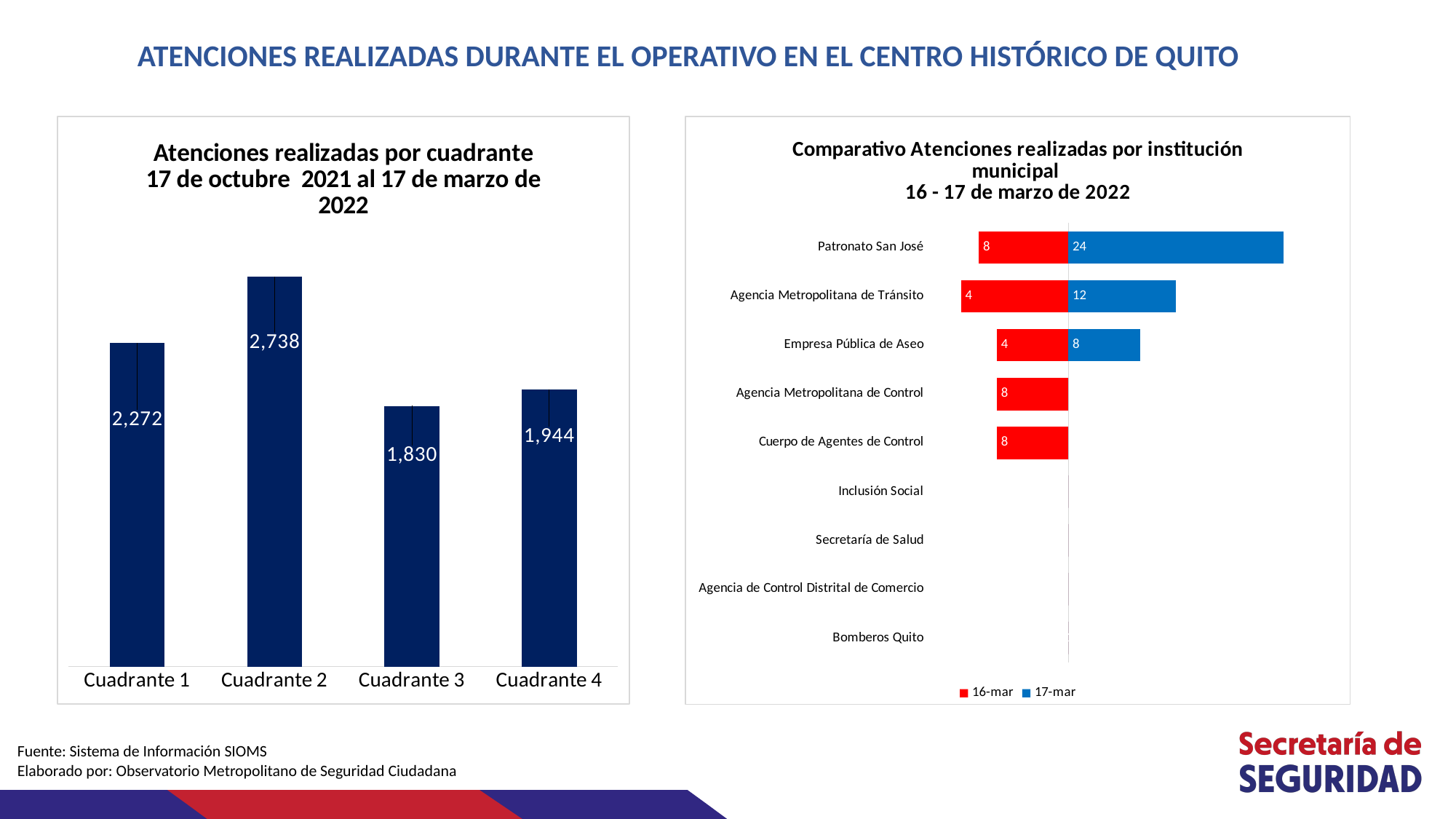
In the 'Comparativo Atenciones realizadas por institución municipal' chart, how many series does the legend list? 2 In the 'Comparativo Atenciones realizadas por institución municipal' chart, what is the 16-mar value for Agencia Metropolitana de Tránsito? 4 In the 'Comparativo Atenciones realizadas por institución municipal' chart, what is the 17-mar value for Patronato San José? 24 What kind of chart is the 'Atenciones realizadas por cuadrante' chart? Bar chart In the 'Comparativo Atenciones realizadas por institución municipal' chart, what is the difference between the 17-mar and 16-mar values for Empresa Pública de Aseo? 4 In the 'Atenciones realizadas por cuadrante' chart, how many cuadrantes are shown? 4 In the 'Atenciones realizadas por cuadrante' chart, what is the difference between Cuadrante 1 and Cuadrante 4? 328 In the 'Atenciones realizadas por cuadrante' chart, which cuadrante has the lowest value? Cuadrante 3 In the 'Comparativo Atenciones realizadas por institución municipal' chart, which institution has the highest 17-mar value? Patronato San José In the 'Atenciones realizadas por cuadrante' chart, what is the value for Cuadrante 2? 2,738 In the 'Atenciones realizadas por cuadrante' chart, which cuadrante has the highest value? Cuadrante 2 In the 'Comparativo Atenciones realizadas por institución municipal' chart, which colour represents the 16-mar series? Red